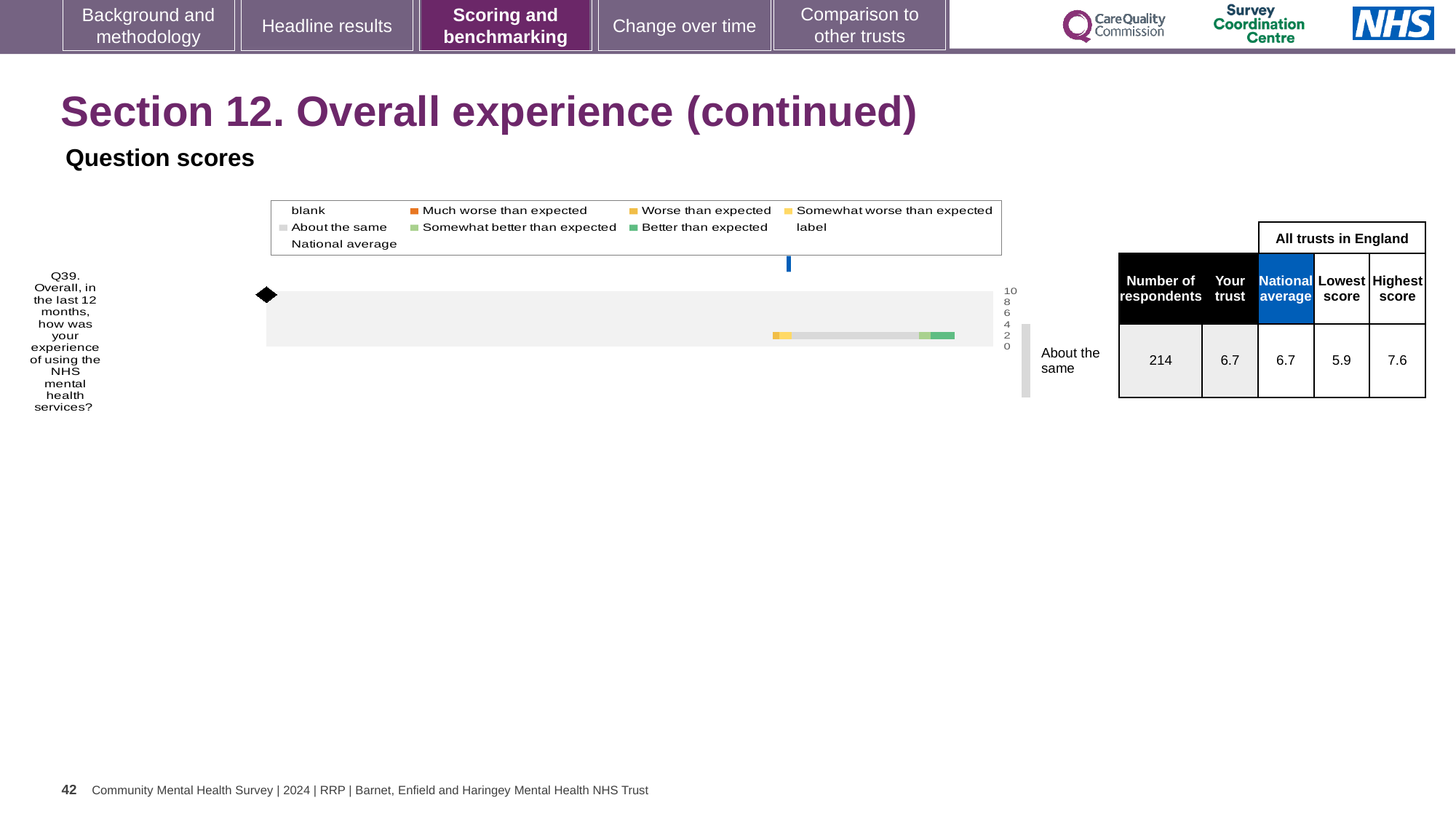
What is the lowest score among all trusts in England for Q39? 5.9 What kind of chart is shown on the slide? bar chart What is the highest value shown on the chart's axis? 10 What is the highest score among all trusts in England for Q39? 7.6 How many respondents answered Q39? 214 How many questions (categories) are plotted in the chart? 1 What rating label is shown next to the bar for Q39? About the same Is the 'Your trust' score for Q39 greater or less than 4? greater What is the 'Your trust' score for Q39? 6.7 Which question is plotted in the chart? Q39. Overall, in the last 12 months, how was your experience of using the NHS mental health services? What is the national average score for Q39? 6.7 What is the difference between the highest score and the lowest score for Q39? 1.7